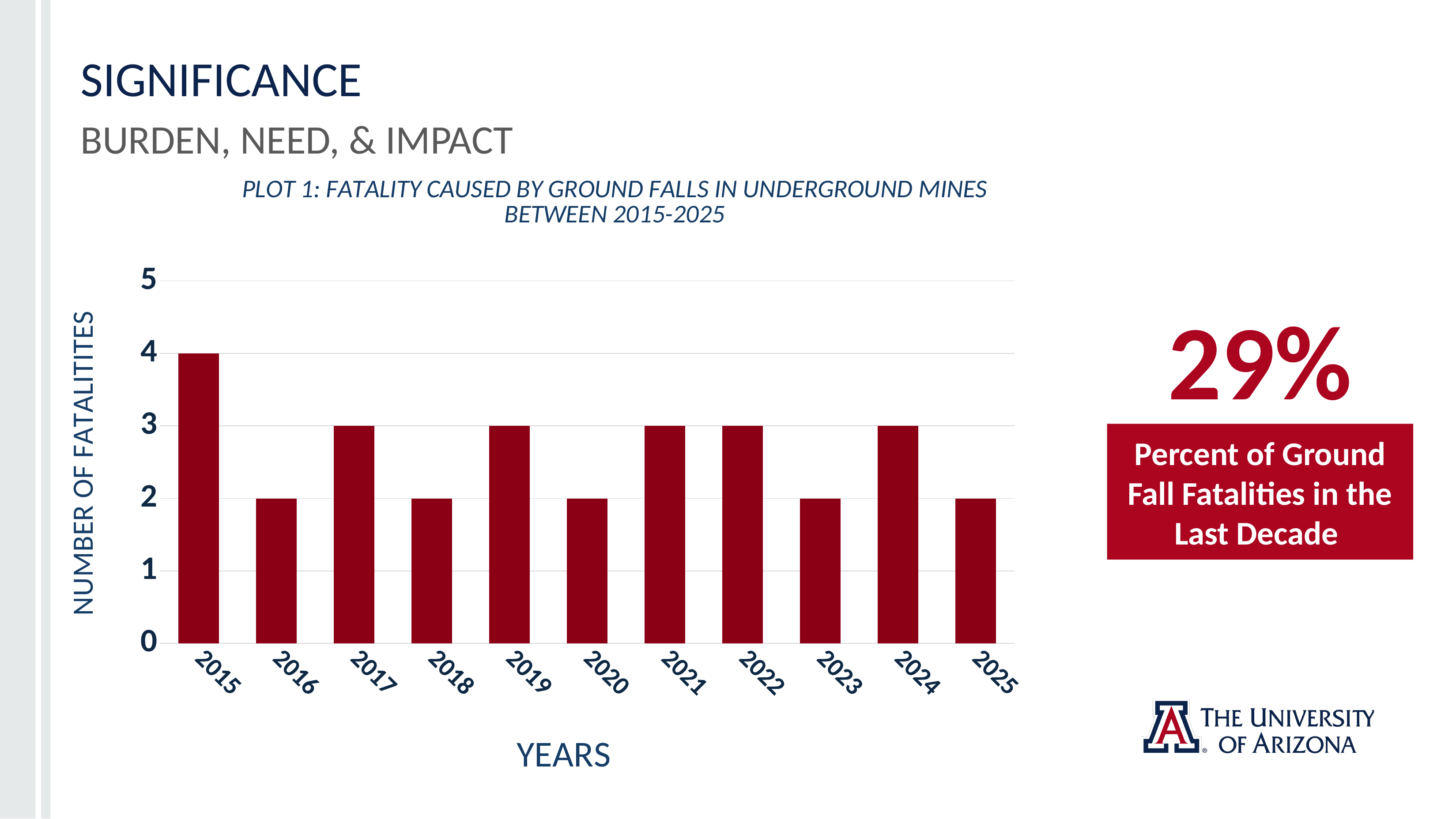
How many fatalities are shown for 2015? 4 What is the label of the y axis? NUMBER OF FATALITITES Which year has more fatalities, 2017 or 2018? 2017 How many fatalities are shown for 2020? 2 Is the value for 2015 greater or less than 3? greater What is the difference in fatalities between 2015 and 2016? 2 What kind of chart is shown on the slide? bar chart What is the difference in fatalities between 2021 and 2023? 1 How many fatalities are shown for 2024? 3 What is the label of the x axis? YEARS Which year has the highest number of fatalities? 2015 How many years are shown on the x axis? 11